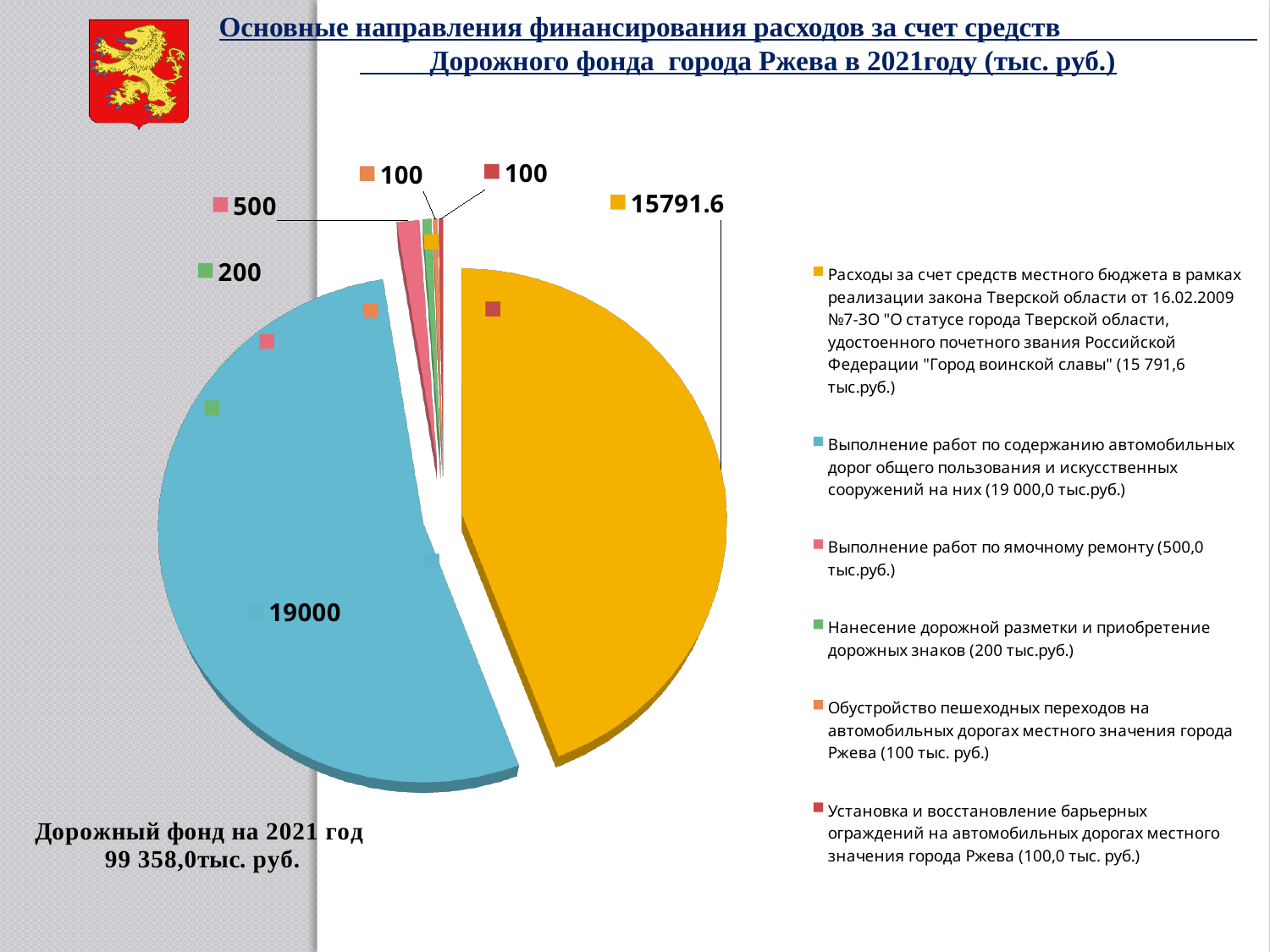
What kind of chart is shown on the slide? pie chart How many entries does the legend list? 6 Which category has the largest slice in the pie chart? Выполнение работ по содержанию автомобильных дорог общего пользования и искусственных сооружений на них What is the difference between the 19000 slice and the 15791.6 slice? 3208.4 What is the value of the slice for "Выполнение работ по ямочному ремонту"? 500 What is the value of the slice for "Обустройство пешеходных переходов на автомобильных дорогах местного значения города Ржева"? 100 Which is larger: the slice for "Выполнение работ по ямочному ремонту" or the slice for "Нанесение дорожной разметки и приобретение дорожных знаков"? Выполнение работ по ямочному ремонту What colour is the slice representing 19000? blue What is the value of the slice for "Расходы за счет средств местного бюджета в рамках реализации закона Тверской области от 16.02.2009 №7-ЗО"? 15791.6 How many slices does the pie chart have? 6 What is the value of the slice for "Выполнение работ по содержанию автомобильных дорог общего пользования и искусственных сооружений на них"? 19000 What is the value of the slice for "Нанесение дорожной разметки и приобретение дорожных знаков"? 200